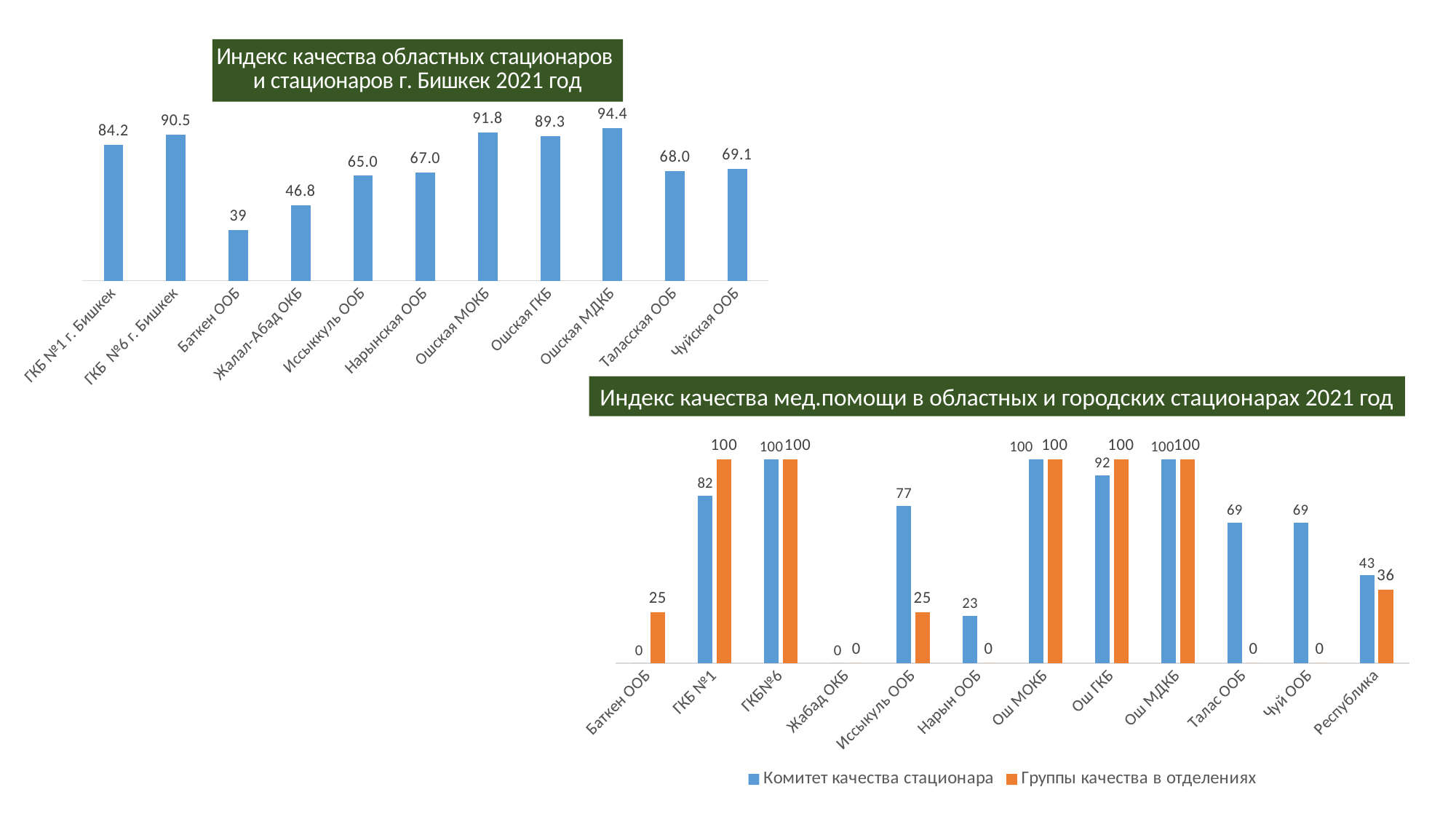
In the chart titled "Индекс качества областных стационаров и стационаров г. Бишкек 2021 год", which category has the highest value? Ошская МДКБ In the chart titled "Индекс качества областных стационаров и стационаров г. Бишкек 2021 год", how many categories are shown? 11 In the chart titled "Индекс качества мед.помощи в областных и городских стационарах 2021 год", what is the value of Группы качества в отделениях for Республика? 36 In the chart titled "Индекс качества мед.помощи в областных и городских стационарах 2021 год", what is the value of Комитет качества стационара for Иссыкуль ООБ? 77 In the chart titled "Индекс качества мед.помощи в областных и городских стационарах 2021 год", how many categories are shown on the x axis? 12 In the chart titled "Индекс качества областных стационаров и стационаров г. Бишкек 2021 год", which category has the lowest value? Баткен ООБ In the chart titled "Индекс качества областных стационаров и стационаров г. Бишкек 2021 год", which is larger: the value for Таласская ООБ or Чуйская ООБ? Чуйская ООБ What type of chart is the chart titled "Индекс качества мед.помощи в областных и городских стационарах 2021 год"? Bar chart In the chart titled "Индекс качества мед.помощи в областных и городских стационарах 2021 год", what is the difference between the Группы качества в отделениях value and the Комитет качества стационара value for ГКБ №1? 18 In the chart titled "Индекс качества областных стационаров и стационаров г. Бишкек 2021 год", what is the value for Баткен ООБ? 39 In the chart titled "Индекс качества мед.помощи в областных и городских стационарах 2021 год", how many series does the legend list? 2 In the chart titled "Индекс качества областных стационаров и стационаров г. Бишкек 2021 год", what is the difference between the values for ГКБ №6 г. Бишкек and ГКБ №1 г. Бишкек? 6.3